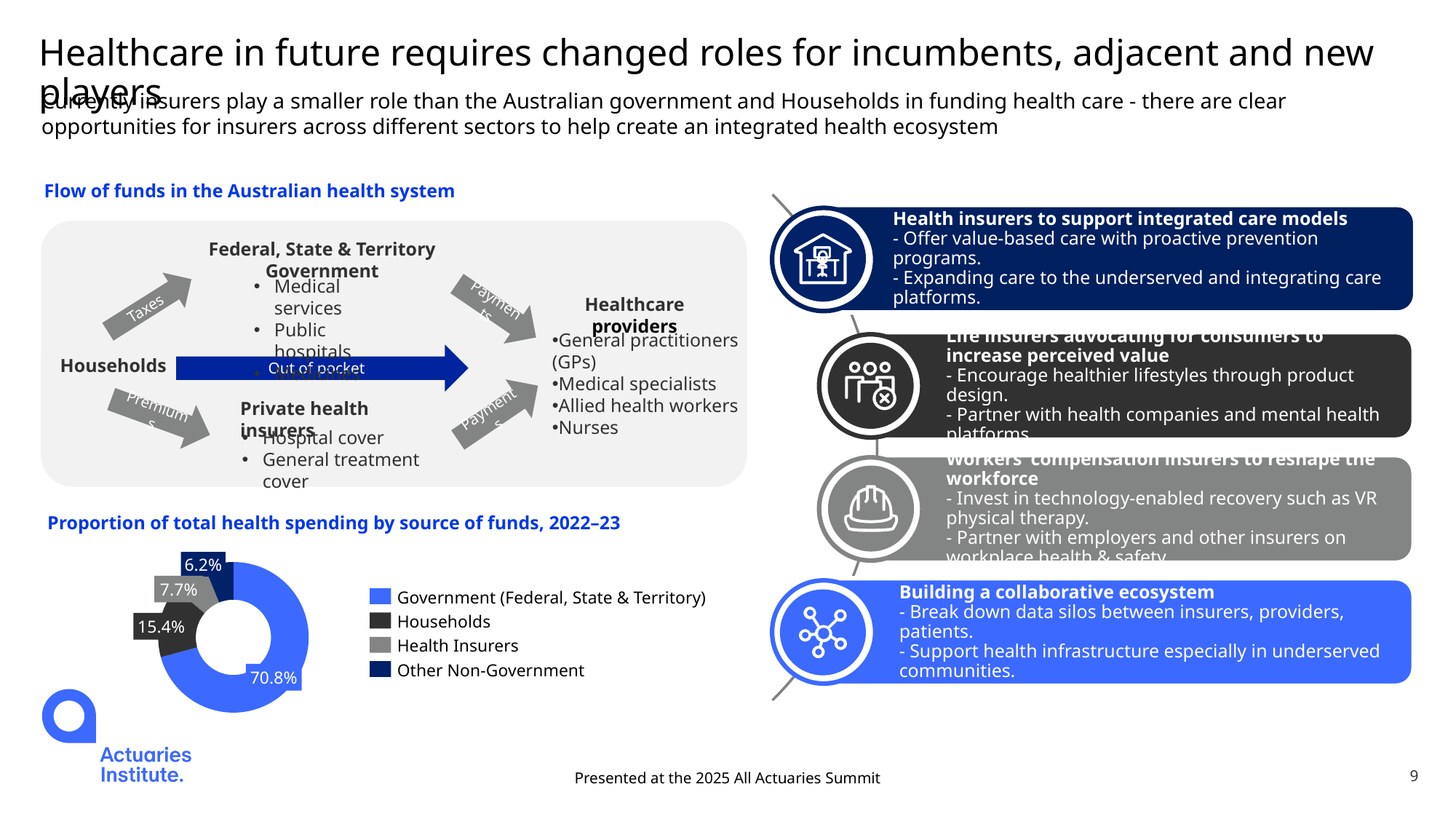
What share of total health spending comes from Government (Federal, State & Territory) in the chart? 70.8% Which source of funds has the largest share of total health spending? Government (Federal, State & Territory) Which has a larger share of total health spending, Households or Health Insurers? Households What share of total health spending comes from Households? 15.4% What colour represents Households in the chart? Dark grey What share of total health spending comes from Other Non-Government sources? 6.2% What share of total health spending comes from Health Insurers? 7.7% What kind of chart is used to show the proportion of total health spending by source of funds? Pie (donut) chart What is the title of the chart on the slide? Proportion of total health spending by source of funds, 2022–23 How many sources of funds are shown in the chart? 4 What is the difference in percentage points between the Households share and the Health Insurers share? 7.7 Which source of funds has the smallest share of total health spending? Other Non-Government